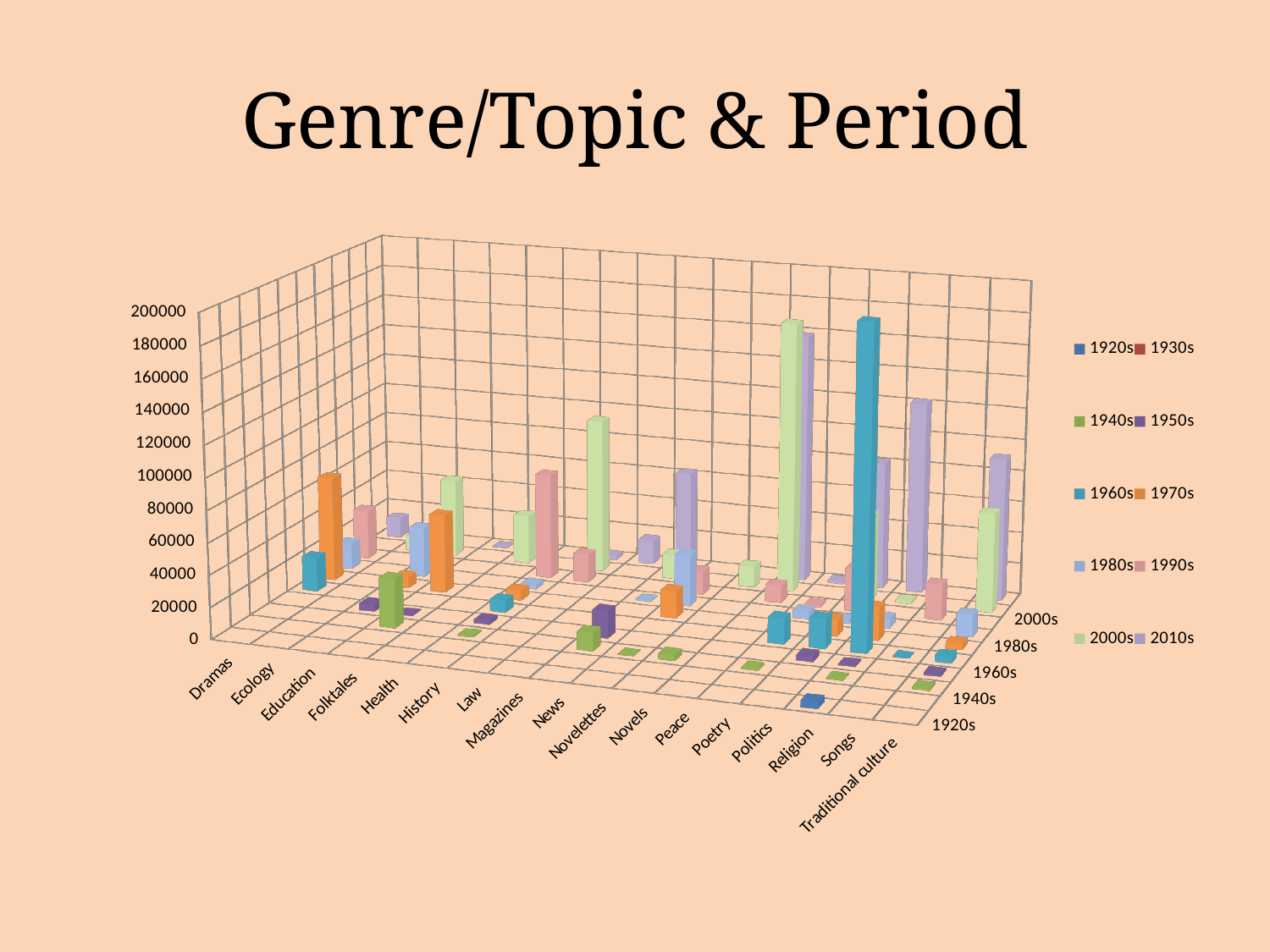
Which period is the first entry in the legend? 1920s Which is larger for Politics: the 2000s value or the 1920s value? 2000s How many series (periods) does the legend list? 10 What is the title of the chart? Genre/Topic & Period Is the 2000s value for Politics greater or less than 100000? less Is the 1940s value for Poetry greater or less than 20000? less Is the 1960s value for Songs greater or less than 100000? less How many genre/topic categories are shown along the x axis? 17 What kind of chart is shown on the slide? bar chart